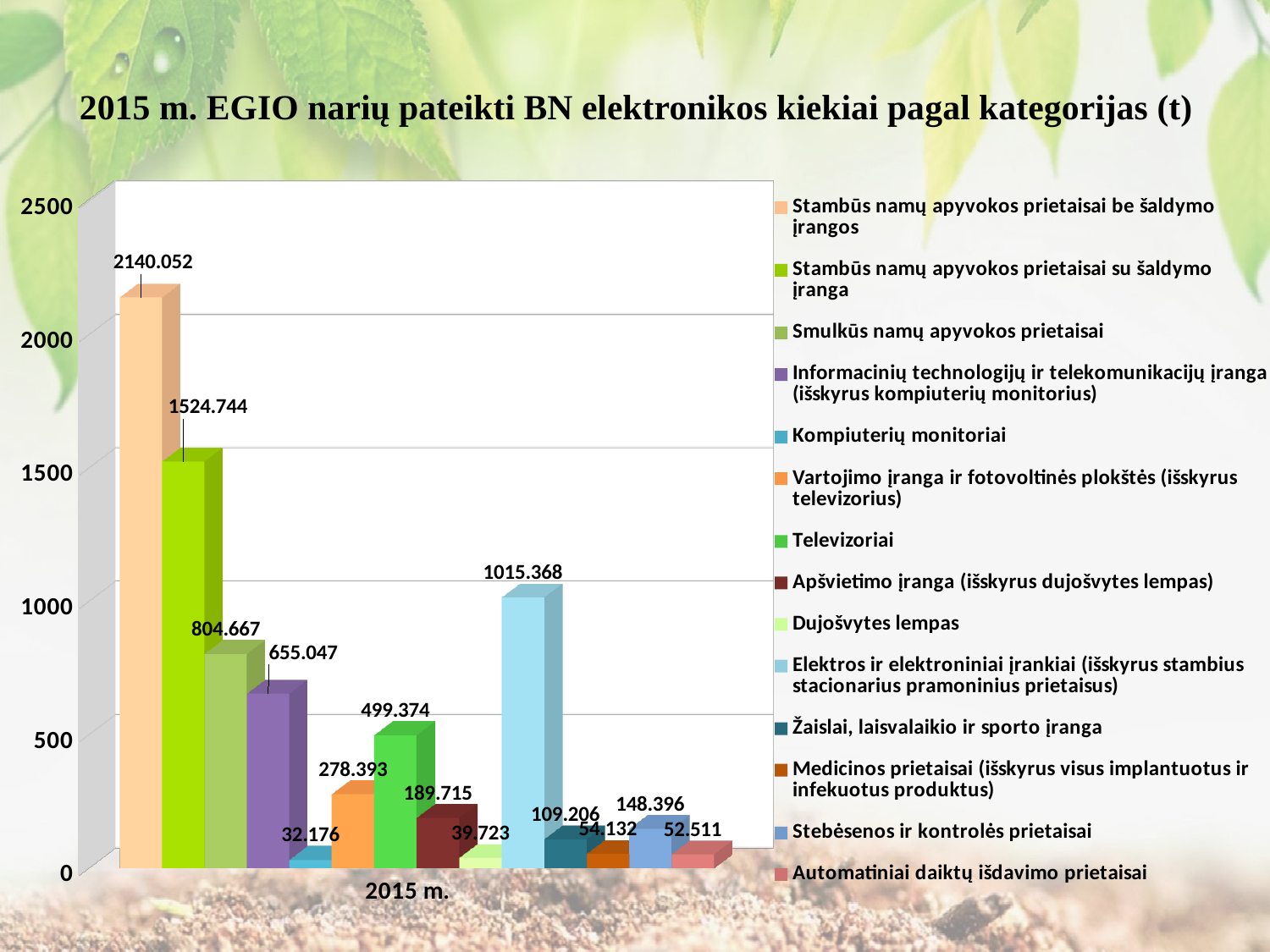
Which series has the lowest value? Kompiuterių monitoriai What is the value for Kompiuterių monitoriai? 32.176 What is the value for Stambūs namų apyvokos prietaisai be šaldymo įrangos? 2140.052 Which series has the highest value? Stambūs namų apyvokos prietaisai be šaldymo įrangos What is the value for Televizoriai? 499.374 Which is larger, the value for Smulkūs namų apyvokos prietaisai or the value for Elektros ir elektroniniai įrankiai? Elektros ir elektroniniai įrankiai Is the value for Informacinių technologijų ir telekomunikacijų įranga greater or less than 500? greater What kind of chart is shown on the slide? bar chart How many series does the legend list? 14 What is the difference between the values for Stambūs namų apyvokos prietaisai be šaldymo įrangos and Stambūs namų apyvokos prietaisai su šaldymo įranga? 615.308 What is the title of the chart? 2015 m. EGIO narių pateikti BN elektronikos kiekiai pagal kategorijas (t) What is the value for Elektros ir elektroniniai įrankiai (išskyrus stambius stacionarius pramoninius prietaisus)? 1015.368